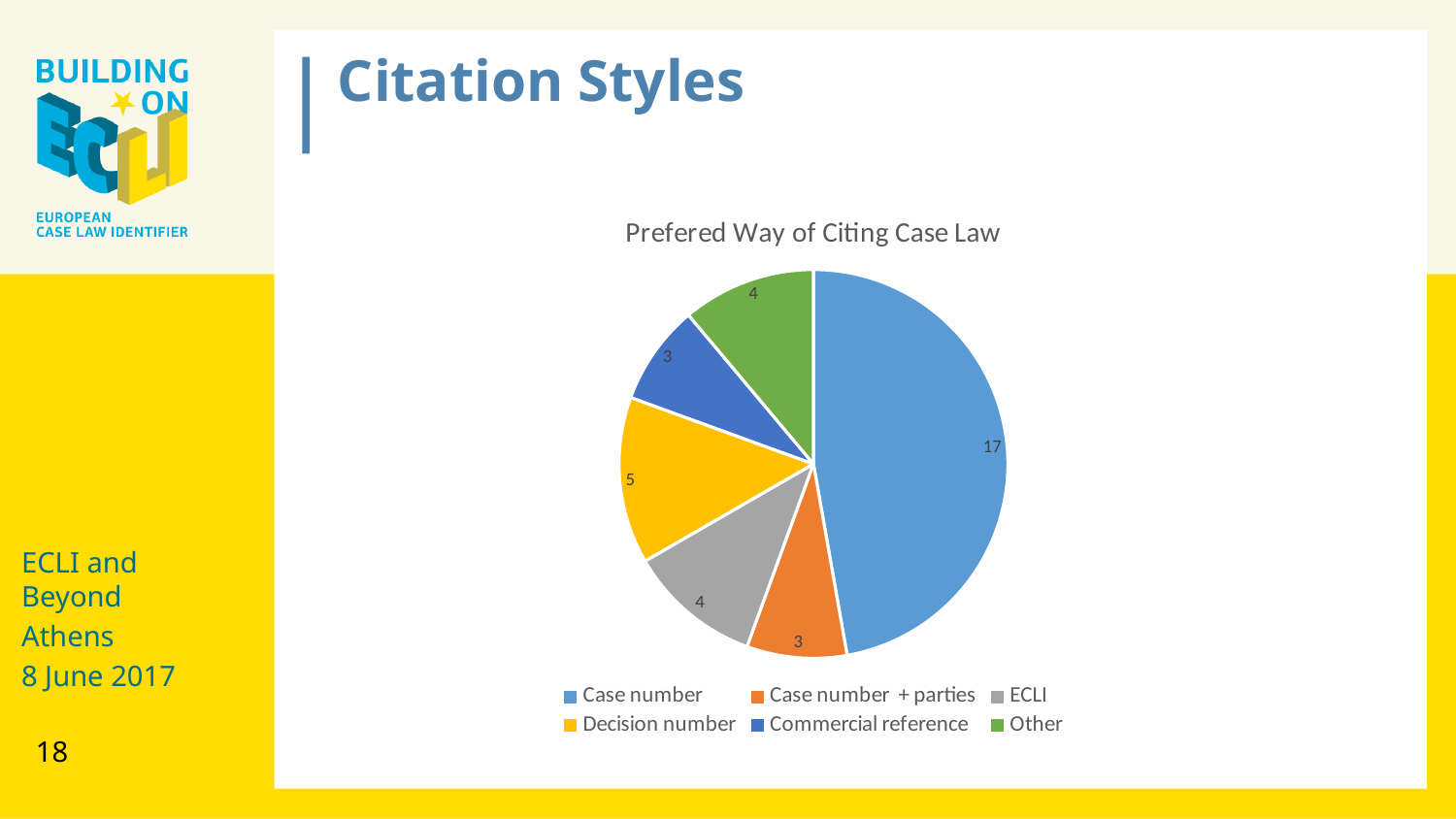
What is the value for Decision number? 5 What is the difference between the values for Case number and Decision number? 12 Which categories share the smallest value in the pie? Case number + parties and Commercial reference What is the value for Case number? 17 What is the value for ECLI? 4 Which category has the largest slice of the pie? Case number What is the title of the chart? Prefered Way of Citing Case Law What kind of chart is shown on the slide? pie chart How many categories does the pie chart have? 6 What is the value for Commercial reference? 3 Which is larger, the value for Decision number or the value for ECLI? Decision number